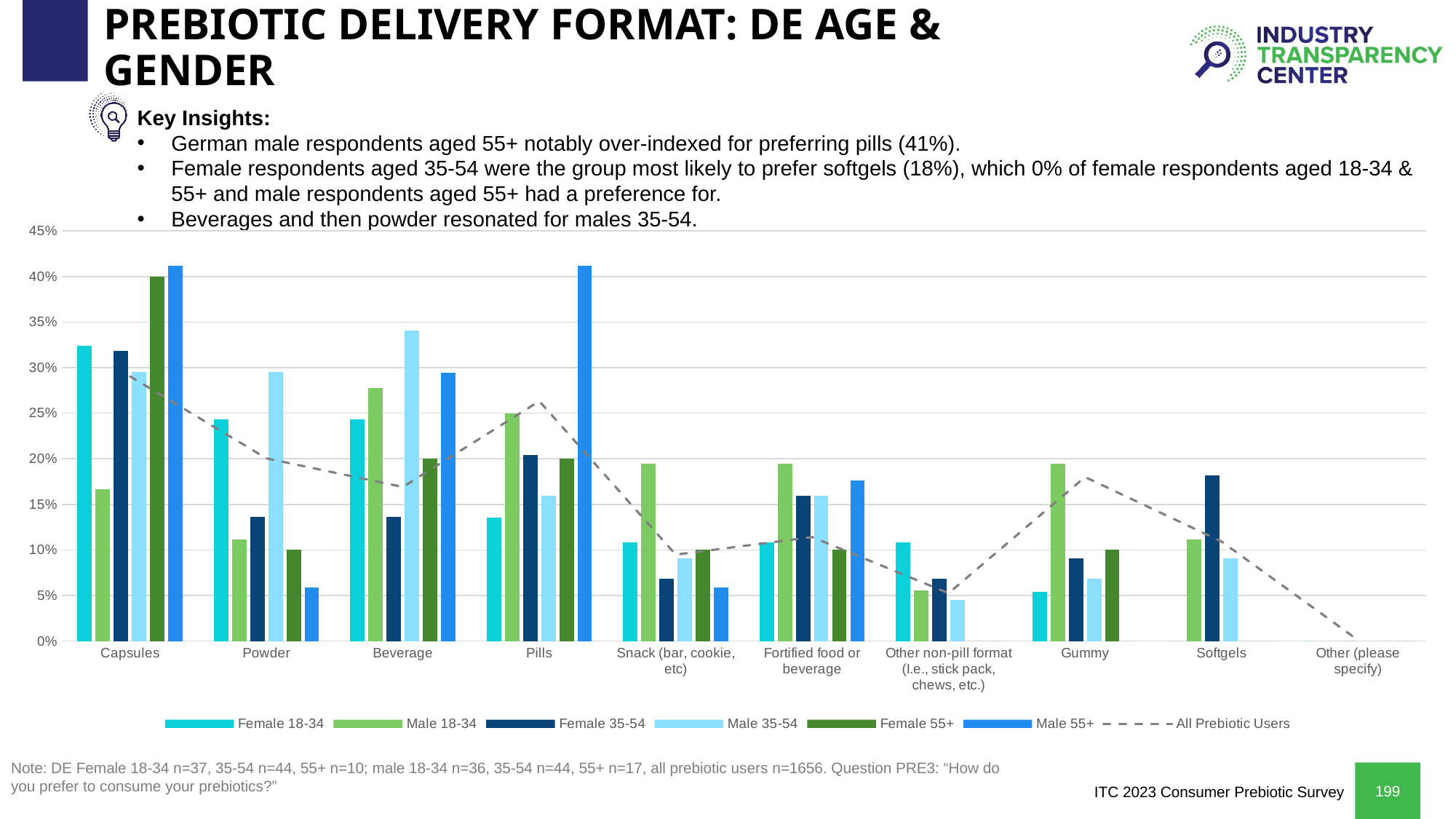
How many delivery format categories are shown on the x axis? 10 Is the Male 18-34 value for Capsules greater or less than 20%? less For Powder, which is larger: the Male 35-54 bar or the Female 35-54 bar? Male 35-54 Which category has the highest Female 18-34 bar? Capsules Is the Female 35-54 value for Capsules greater or less than 30%? greater What kind of chart is shown on the slide? combination bar and line chart Is the Female 35-54 value for Softgels greater or less than 15%? greater Which category has the highest Male 35-54 bar? Beverage For Capsules, which is larger: the Female 18-34 bar or the Male 18-34 bar? Female 18-34 How many entries does the chart legend list? 7 Which category has the lowest value on the All Prebiotic Users dashed line? Other (please specify) Does the All Prebiotic Users dashed line rise or fall from Capsules to Beverage? fall